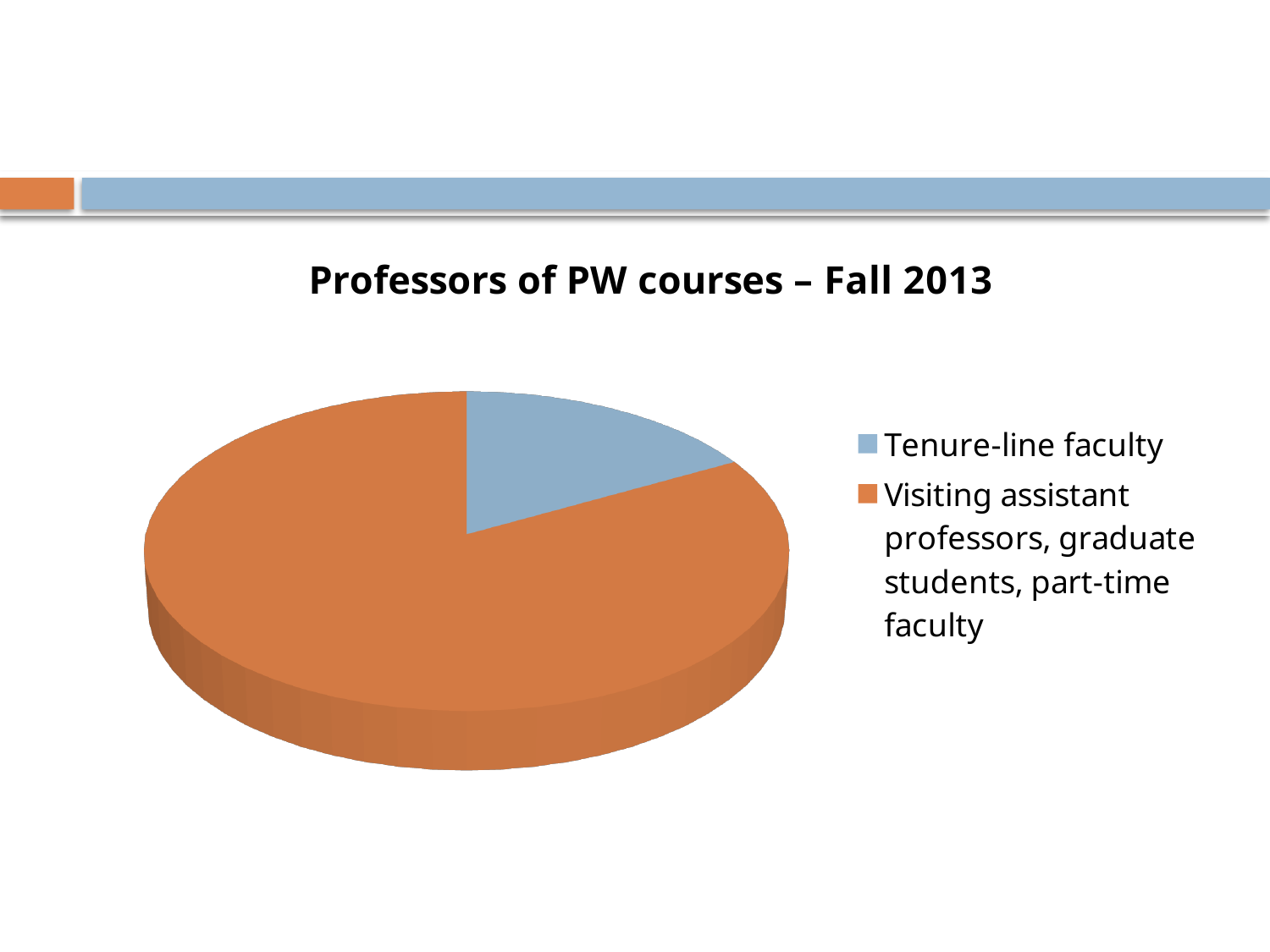
How many entries does the legend list? 2 How many slices does the pie chart have? 2 Which category has the largest slice of the pie? Visiting assistant professors, graduate students, part-time faculty Which slice is larger: Tenure-line faculty or Visiting assistant professors, graduate students, part-time faculty? Visiting assistant professors, graduate students, part-time faculty What colour is the slice for Tenure-line faculty? blue What kind of chart is shown on the slide? pie chart Which category has the smallest slice of the pie? Tenure-line faculty What is the title of the chart? Professors of PW courses – Fall 2013